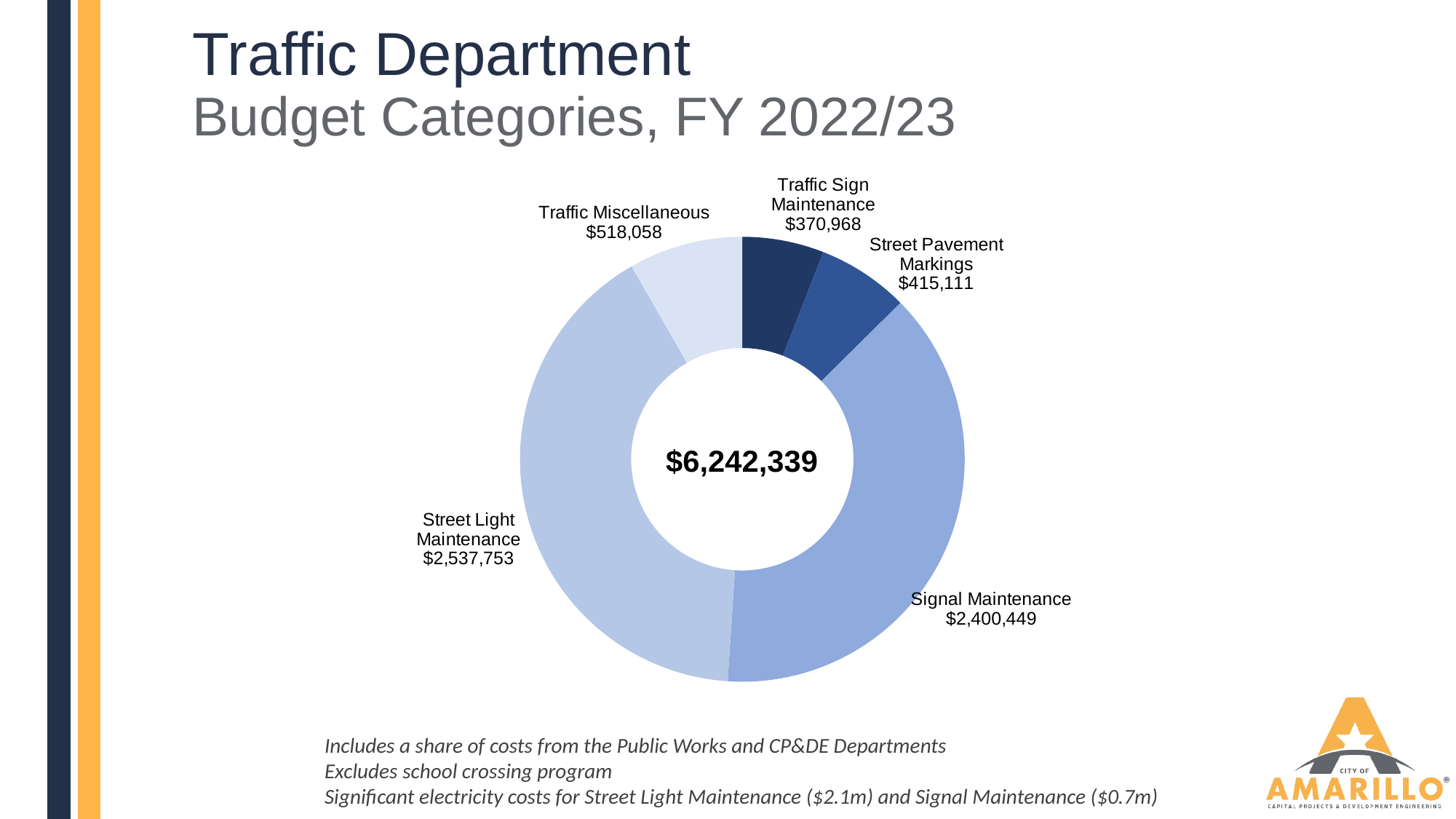
What is the difference between Street Light Maintenance and Signal Maintenance? $137,304 How many budget categories are shown in the chart? 5 What is the budget value for Traffic Miscellaneous? $518,058 What is the difference between Traffic Miscellaneous and Traffic Sign Maintenance? $147,090 Which budget category has the largest value? Street Light Maintenance What kind of chart is shown on the slide? Pie chart (donut) Which budget category has the smallest value? Traffic Sign Maintenance What is the budget value for Street Pavement Markings? $415,111 What is the budget value for Signal Maintenance? $2,400,449 What total value is shown in the center of the chart? $6,242,339 What is the budget value for Traffic Sign Maintenance? $370,968 Which is larger, Street Pavement Markings or Traffic Sign Maintenance? Street Pavement Markings